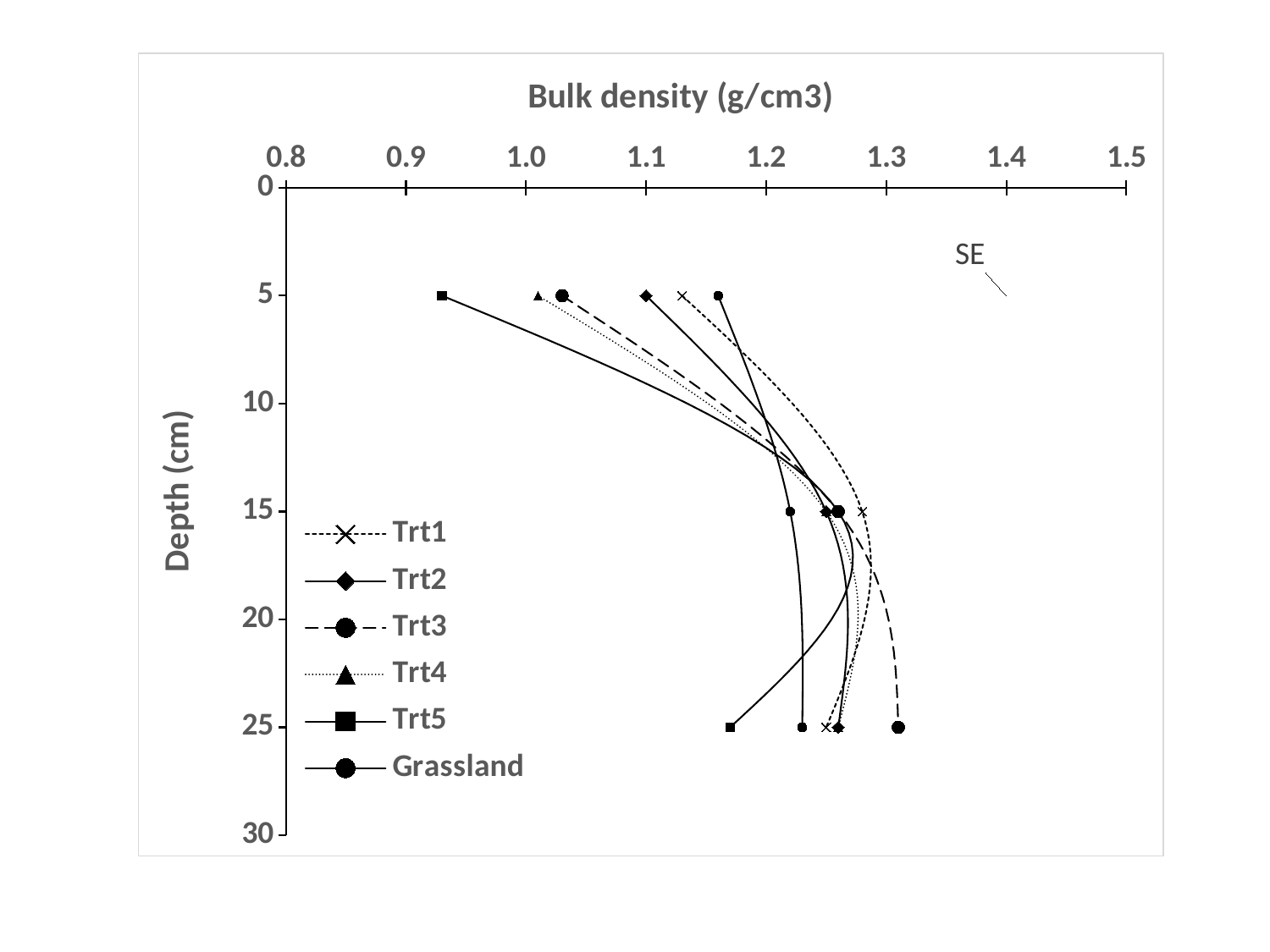
Is the bulk density for Trt5 at 5 cm depth greater or less than 1.0? less How many depth points are plotted for each series? 3 For Trt5, does bulk density increase or decrease from 5 cm depth to 25 cm depth? increase Is the bulk density for Trt5 at 25 cm depth greater or less than 1.1? greater What is the title of the horizontal axis? Bulk density (g/cm3) Which series has the highest bulk density at a depth of 25 cm? Trt3 At a depth of 5 cm, which has the larger bulk density, Trt2 or Trt5? Trt2 Is the bulk density for Grassland at 5 cm depth greater or less than 1.2? less How many series does the legend list? 6 Which series has the lowest bulk density at a depth of 5 cm? Trt5 What kind of chart is shown on the slide? line chart